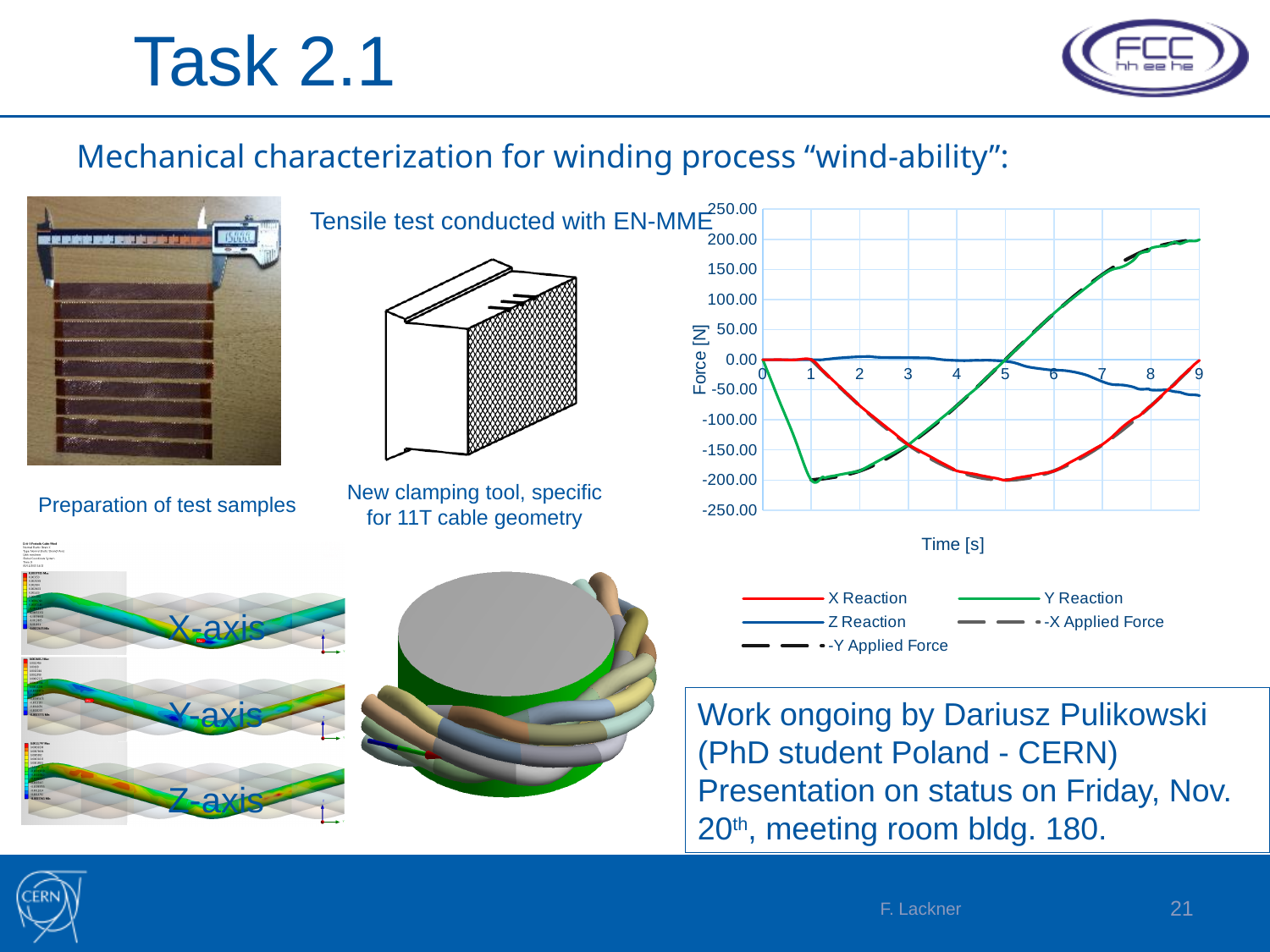
Is the value of Y Reaction at time 1 greater or less than -150? less Which series is drawn in green on the chart? Y Reaction Is the value of X Reaction at time 5 greater or less than -150? less How many series does the chart legend list? 5 At time 9, which is larger: X Reaction or Y Reaction? Y Reaction What is the label of the x axis of the chart? Time [s] Does the Y Reaction series rise or fall between time 1 and time 9? rise What kind of chart is shown on the slide? line chart At time 1, which is larger: X Reaction or Y Reaction? X Reaction Is the value of Z Reaction at time 9 greater or less than 0? less Does the X Reaction series rise or fall between time 0 and time 5? fall